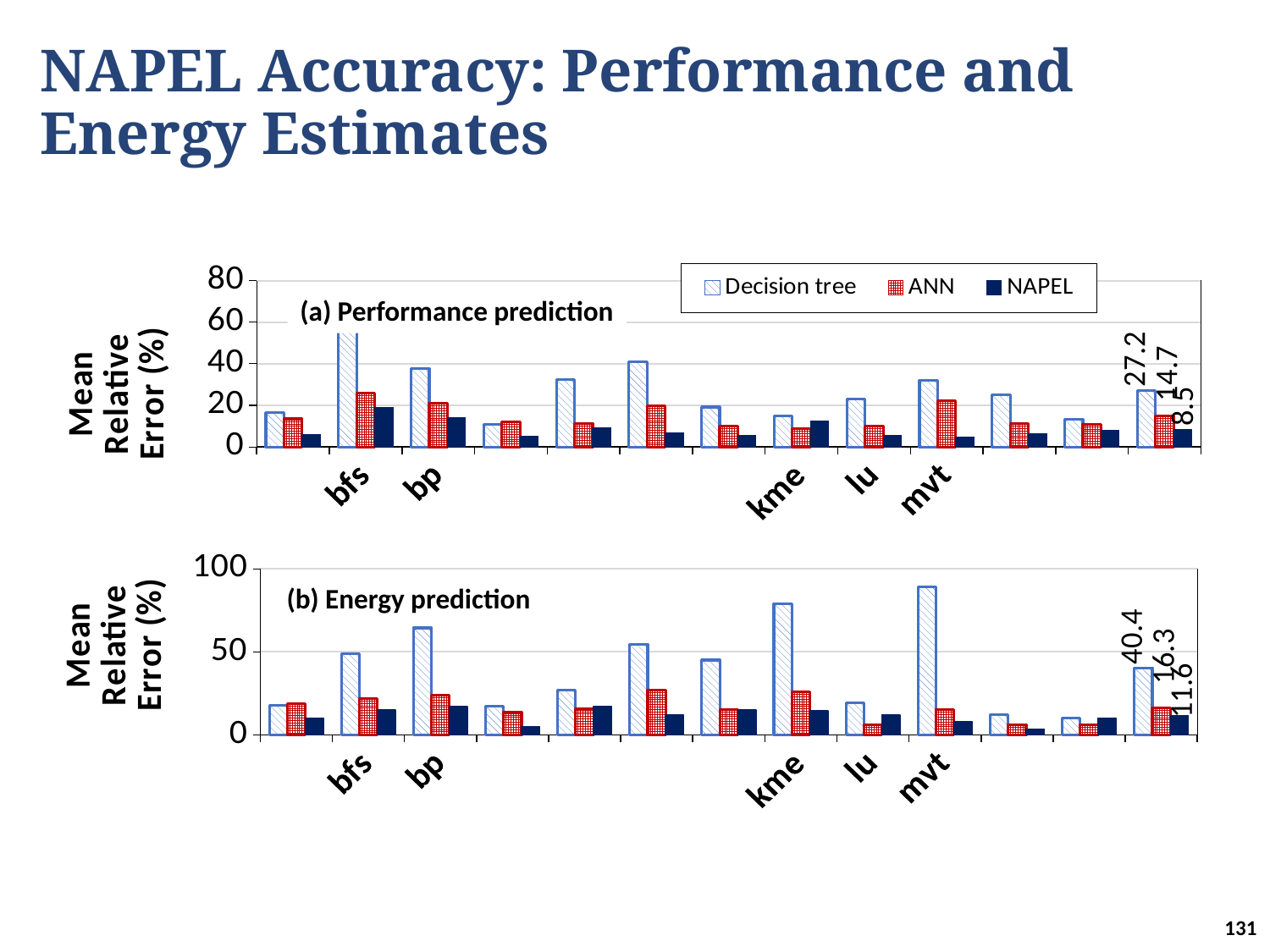
In the '(a) Performance prediction' chart, is the Decision tree value for bfs greater or less than 40? greater In the '(a) Performance prediction' chart, which is larger for bfs: the Decision tree value or the NAPEL value? Decision tree In the '(b) Energy prediction' chart, what is the difference between the labelled Decision tree value (40.4) and the labelled NAPEL value (11.6) in the rightmost group? 28.8 What kind of chart is the '(a) Performance prediction' chart? bar chart In the '(a) Performance prediction' chart, what is the NAPEL value labelled on the rightmost group of bars? 8.5 How many series does the legend list on the slide? 3 In the '(b) Energy prediction' chart, what is the ANN value labelled on the rightmost group of bars? 16.3 In the '(b) Energy prediction' chart, is the Decision tree value for mvt greater or less than 50? greater In the '(b) Energy prediction' chart, which of the labelled categories has the highest Decision tree bar? mvt In the '(a) Performance prediction' chart, what are the three series named in the legend? Decision tree, ANN, NAPEL In the '(a) Performance prediction' chart, what is the Decision tree value labelled on the rightmost group of bars? 27.2 How many groups of bars are plotted in the '(b) Energy prediction' chart? 13